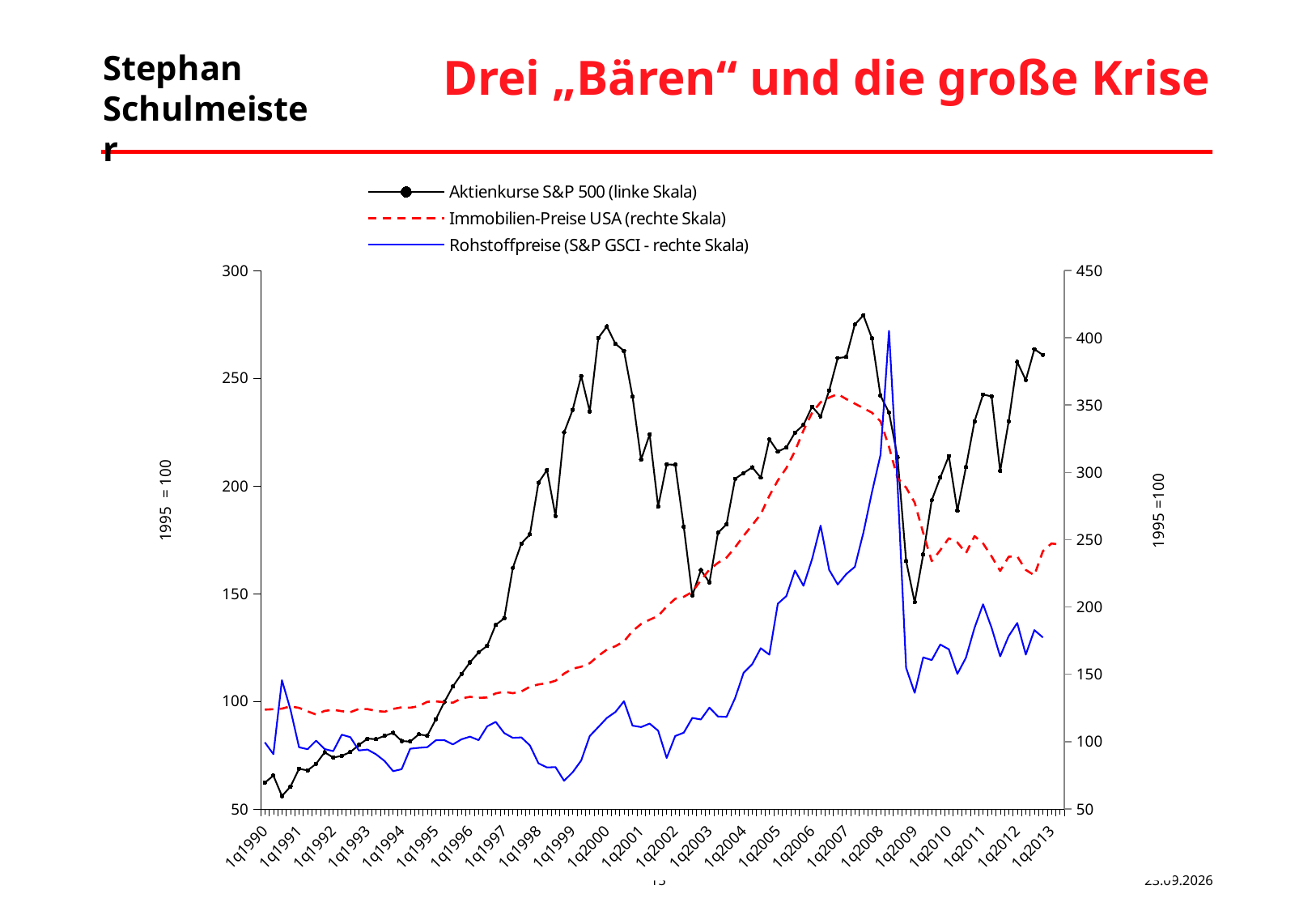
Is the peak value of Rohstoffpreise (S&P GSCI) around 2008 greater or less than 350 on the right scale? greater Of the two series plotted on the right scale, which reaches the higher peak? Rohstoffpreise (S&P GSCI - rechte Skala) How many series does the legend list? 3 Which series is drawn as a red dashed line? Immobilien-Preise USA (rechte Skala) What is the title of the slide's chart? Drei „Bären“ und die große Krise Is the value of Aktienkurse S&P 500 at 1q2000 greater or less than 250 on the left scale? greater Is the value of Aktienkurse S&P 500 at 1q2009 greater or less than 200 on the left scale? less Do the Rohstoffpreise (S&P GSCI) rise or fall between 1q2003 and 1q2008? rise How many year labels (1q1990 to 1q2013) are shown on the x axis? 24 What kind of chart is shown on the slide? line chart Do the Aktienkurse S&P 500 rise or fall between 1q2007 and 1q2009? fall